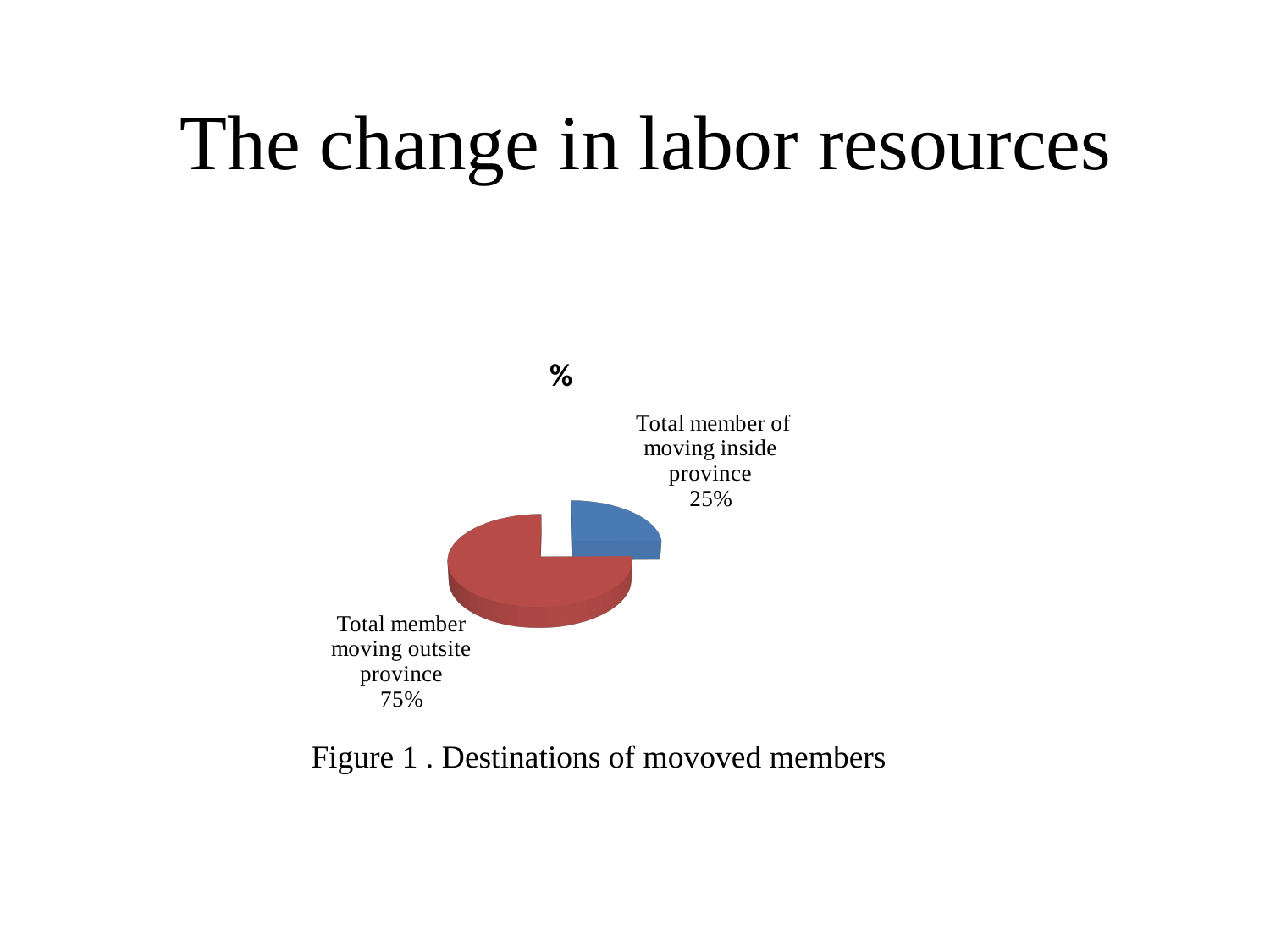
Which is larger: the share moving inside the province or the share moving outside the province? Total member moving outsite province Which slice of the pie is the smallest? Total member of moving inside province What is the title shown above the pie chart? % What kind of chart is shown on the slide? Pie chart What is the figure caption below the chart? Figure 1 . Destinations of movoved members Which slice of the pie is the largest? Total member moving outsite province What is the difference in percentage points between the outside-province slice and the inside-province slice? 50 How many slices does the pie chart have? 2 What share of the pie is labelled "Total member moving outsite province"? 75% What share of the pie is labelled "Total member of moving inside province"? 25%